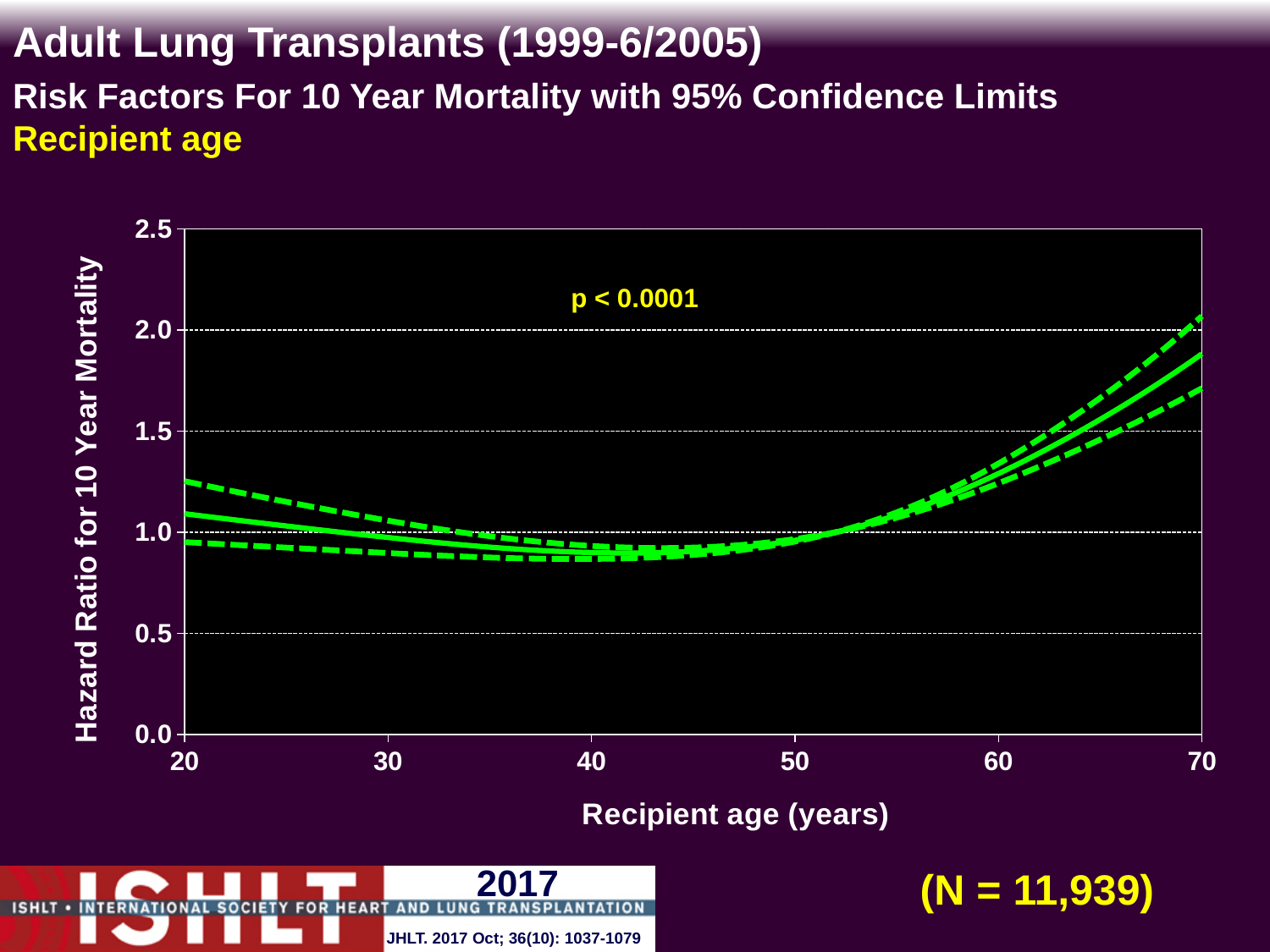
Which recipient age has the larger hazard ratio, 40 or 60? 60 How many lines are plotted on the chart? 3 What is the label of the x axis? Recipient age (years) What sample size (N) is shown on the slide? N = 11,939 What kind of chart is shown on the slide? line chart What is the highest value shown on the y axis? 2.5 Is the hazard ratio (solid line) at recipient age 60 greater or less than 1.0? greater Does the hazard ratio rise or fall as recipient age increases from 50 to 70 years? rise Is the hazard ratio (solid line) at recipient age 40 greater or less than 1.0? less Is the hazard ratio (solid line) at recipient age 70 greater or less than 1.5? greater What p-value is printed on the chart? p < 0.0001 What is the label of the y axis? Hazard Ratio for 10 Year Mortality